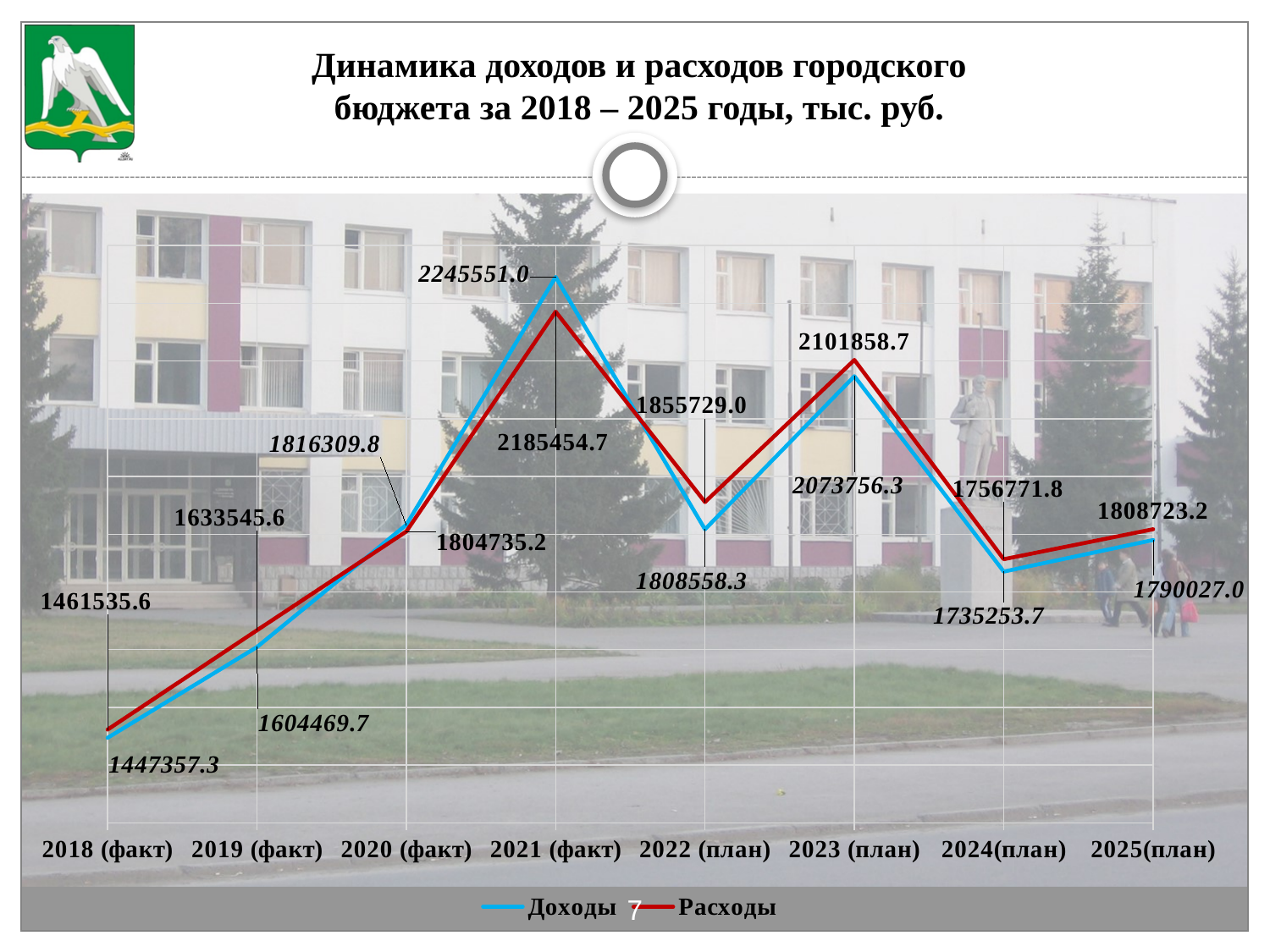
What kind of chart is shown on the slide? line chart What is the value of Расходы for 2023 (план)? 2101858.7 For 2022 (план), which is larger: Доходы or Расходы? Расходы What is the value of Доходы for 2025(план)? 1790027.0 In which year is Расходы lowest? 2018 (факт) What is the difference between Доходы and Расходы in 2021 (факт)? 60096.3 In which year is Доходы highest? 2021 (факт) How many years (categories) are plotted along the x axis? 8 What are the two series named in the legend? Доходы and Расходы What is the value of Доходы for 2021 (факт)? 2245551.0 How many series does the legend list? 2 Do the Доходы values rise or fall from 2018 (факт) to 2021 (факт)? rise